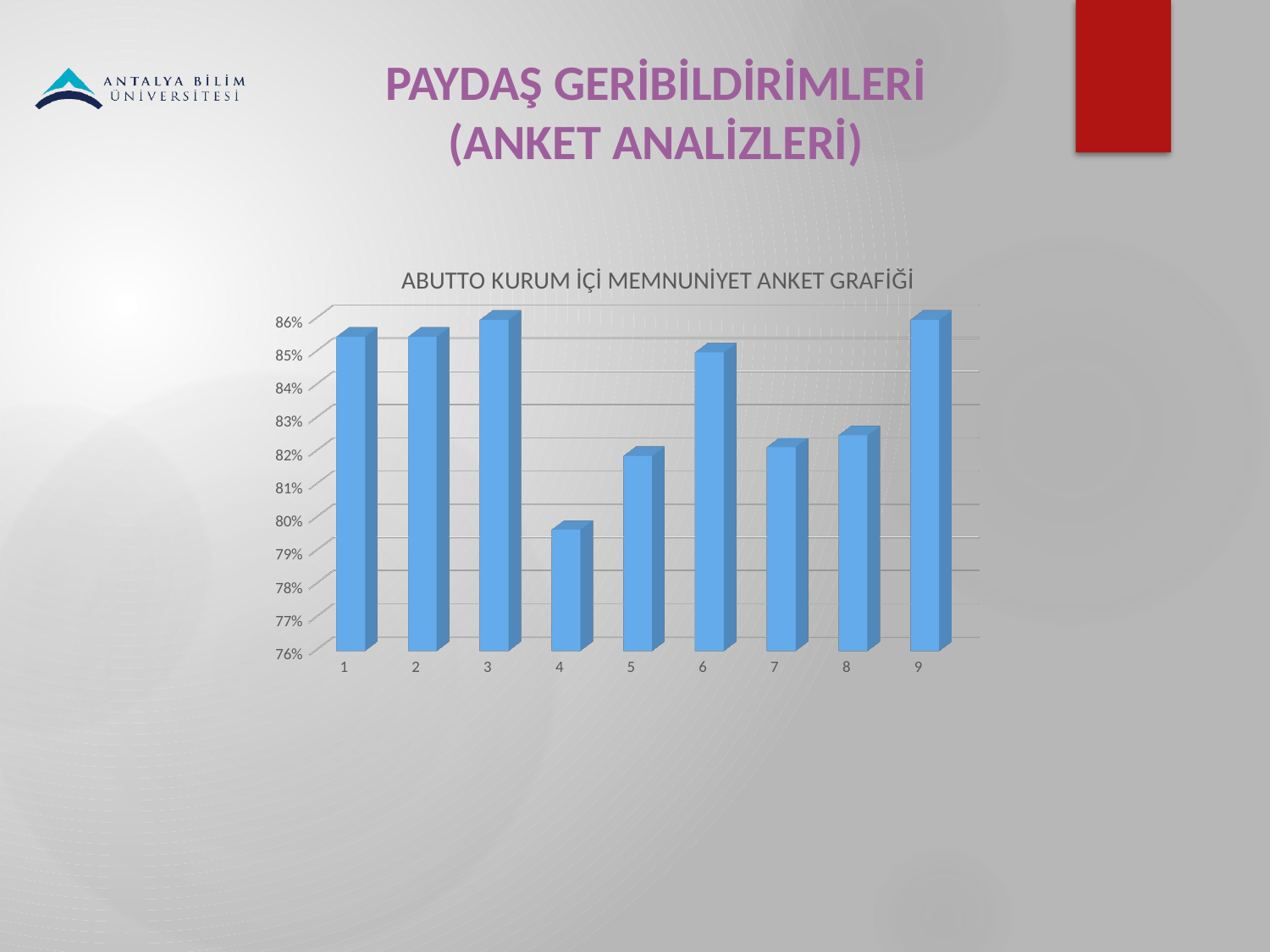
Which has the larger value, category 6 or category 5? 6 What is the title of the chart? ABUTTO KURUM İÇİ MEMNUNİYET ANKET GRAFİĞİ Which has the larger value, category 1 or category 4? 1 How many categories are plotted on the x axis of the chart? 9 Is the value for category 9 greater or less than 84%? greater Is the value for category 6 greater or less than 84%? greater Is the value for category 4 greater or less than 82%? less Which category has the lowest value in the chart? 4 What kind of chart is shown on the slide? bar chart Which has the larger value, category 7 or category 3? 3